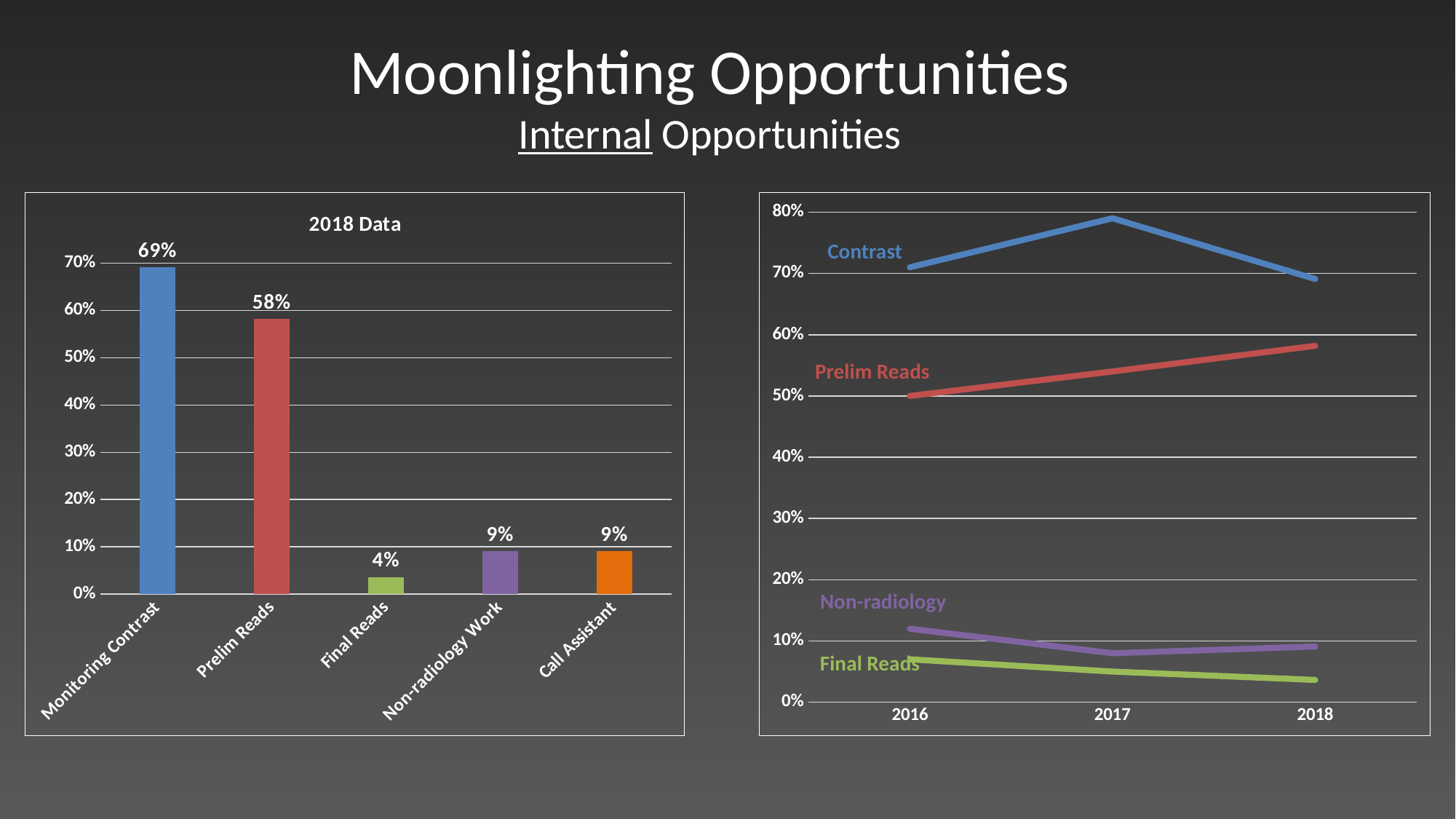
In the 2018 Data bar chart, what is the value for Prelim Reads? 58% How many categories are shown in the 2018 Data bar chart? 5 In the 2018 Data bar chart, what is the value for Monitoring Contrast? 69% How many series are plotted in the line chart on the right? 4 What kind of chart is the chart on the right of the slide? Line chart In the 2018 Data bar chart, which category has the highest value? Monitoring Contrast In the 2018 Data bar chart, which category has the lowest value? Final Reads In the line chart on the right, is the value for Contrast in 2017 greater or less than 70%? greater What kind of chart is the chart on the left of the slide? Bar chart In the line chart on the right, does the Prelim Reads line rise or fall from 2016 to 2018? Rises In the 2018 Data bar chart, which is larger, Final Reads or Non-radiology Work? Non-radiology Work In the 2018 Data bar chart, what is the difference between Monitoring Contrast and Prelim Reads? 11%